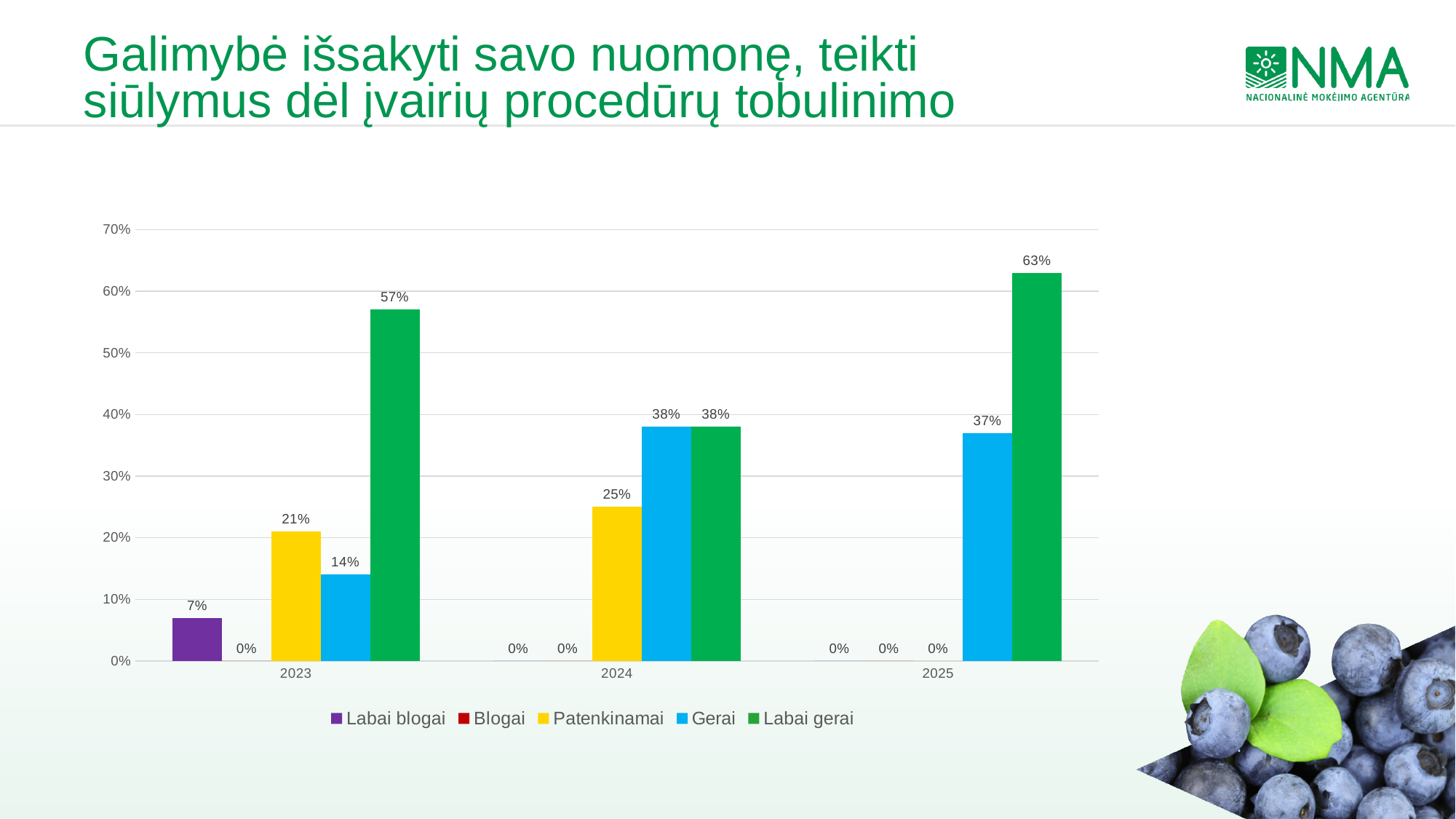
What is the value for Patenkinamai in 2023? 21% What is the value for Gerai in 2024? 38% Does the Labai gerai value rise or fall from 2024 to 2025? Rise What is the value for Labai blogai in 2023? 7% In which year is the Gerai value lowest? 2023 What is the value for Labai gerai in 2025? 63% What is the difference between the Labai gerai values for 2025 and 2023? 6% Which is larger in 2023: Patenkinamai or Gerai? Patenkinamai How many series does the legend list? 5 How many years are shown on the x axis? 3 What kind of chart is shown on the slide? Bar chart In which year is the Labai gerai value highest? 2025